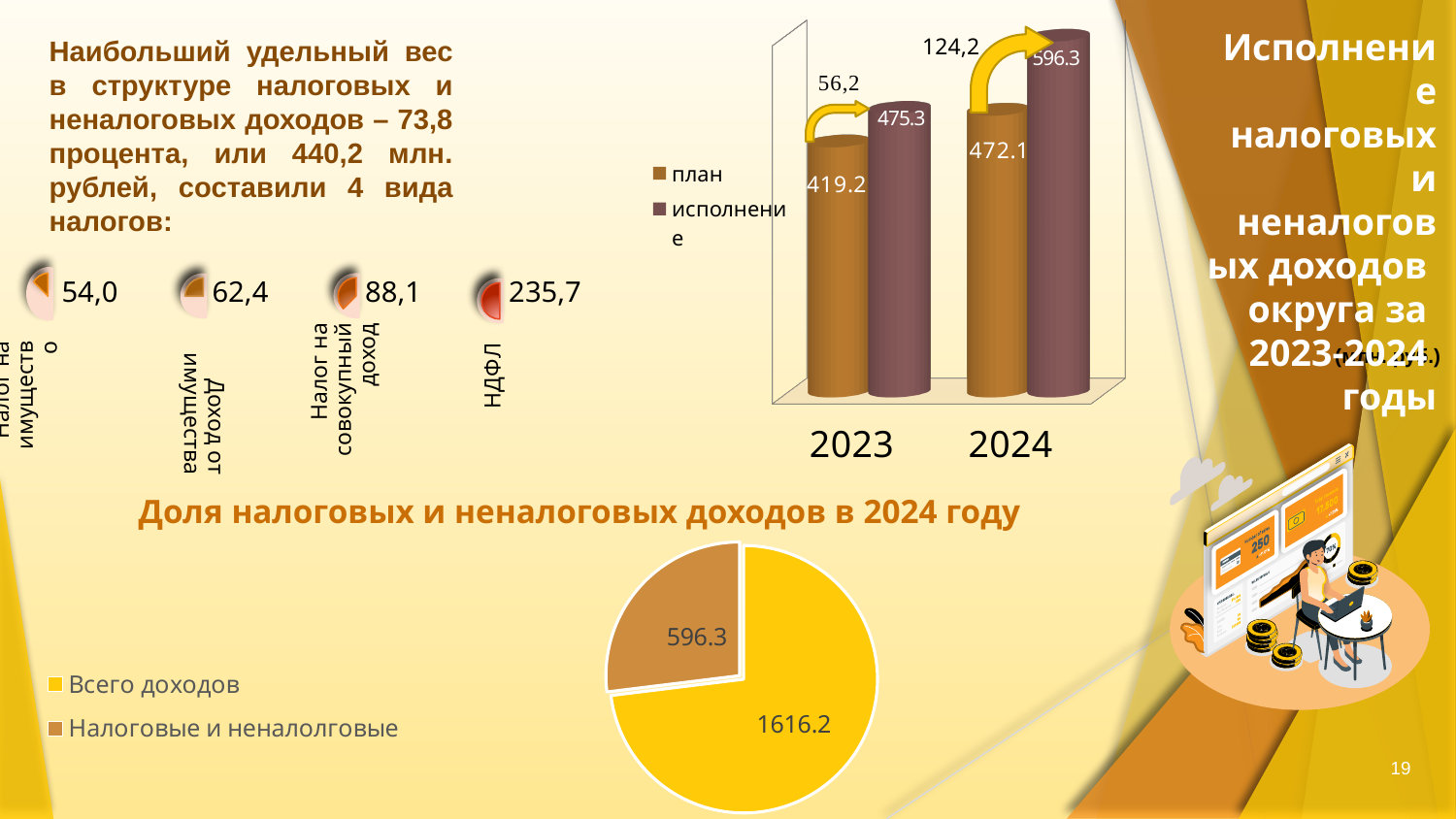
In the bar chart for 2023–2024, what is the value of 'план' for 2024? 472.1 In the pie chart 'Доля налоговых и неналоговых доходов в 2024 году', what is the value for 'Всего доходов'? 1616.2 In the chart of four tax types on the left, what is the value for 'Налог на совокупный доход'? 88,1 In the pie chart 'Доля налоговых и неналоговых доходов в 2024 году', what is the value for 'Налоговые и неналолговые'? 596.3 What kind of chart is the chart at the top right showing 2023 and 2024? bar chart In the bar chart for 2023–2024, what is the value of 'исполнение' for 2024? 596.3 In the bar chart for 2023–2024, does the 'план' value rise or fall from 2023 to 2024? rise In the bar chart for 2023–2024, what is the value of 'план' for 2023? 419.2 In the chart of four tax types on the left, which category has the highest value? НДФЛ In the bar chart for 2023–2024, which is larger: 'исполнение' for 2023 or 'план' for 2024? исполнение for 2023 In the bar chart for 2023–2024, what is the difference between 'исполнение' and 'план' for 2024? 124.2 In the bar chart for 2023–2024, how many series does the legend list? 2